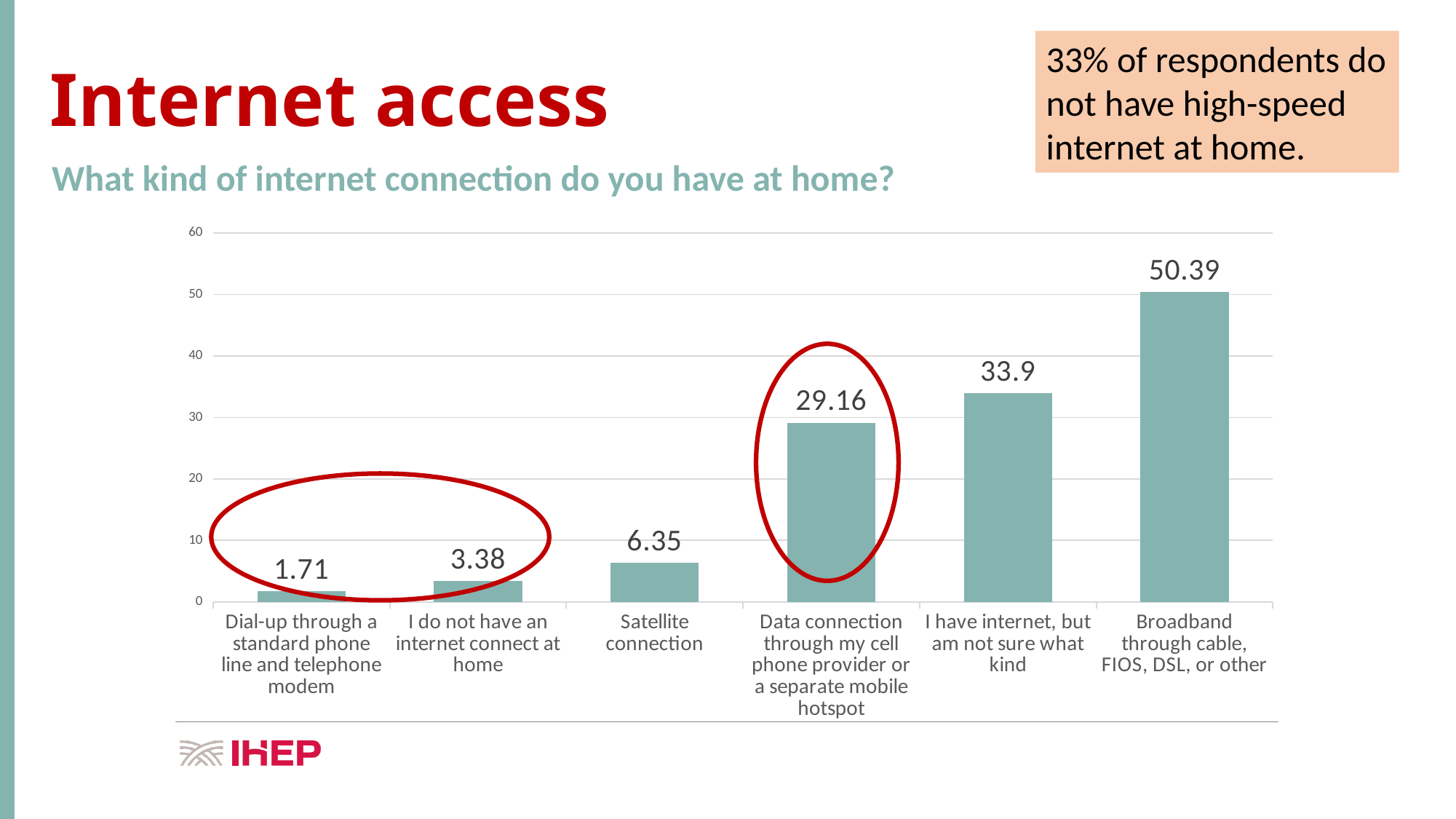
Which category has the highest value? Broadband through cable, FIOS, DSL, or other What is the value for "Satellite connection"? 6.35 Which category has the lowest value? Dial-up through a standard phone line and telephone modem What is the difference between the values for "Broadband through cable, FIOS, DSL, or other" and "I have internet, but am not sure what kind"? 16.49 What question does the chart's subtitle ask? What kind of internet connection do you have at home? What kind of chart is shown on the slide? bar chart What is the value for "Broadband through cable, FIOS, DSL, or other"? 50.39 Is the value for "Satellite connection" greater or less than 10? less Which is larger: the value for "I have internet, but am not sure what kind" or the value for "Data connection through my cell phone provider or a separate mobile hotspot"? I have internet, but am not sure what kind What is the value for "I do not have an internet connect at home"? 3.38 What is the value for "Data connection through my cell phone provider or a separate mobile hotspot"? 29.16 How many categories are shown on the chart? 6